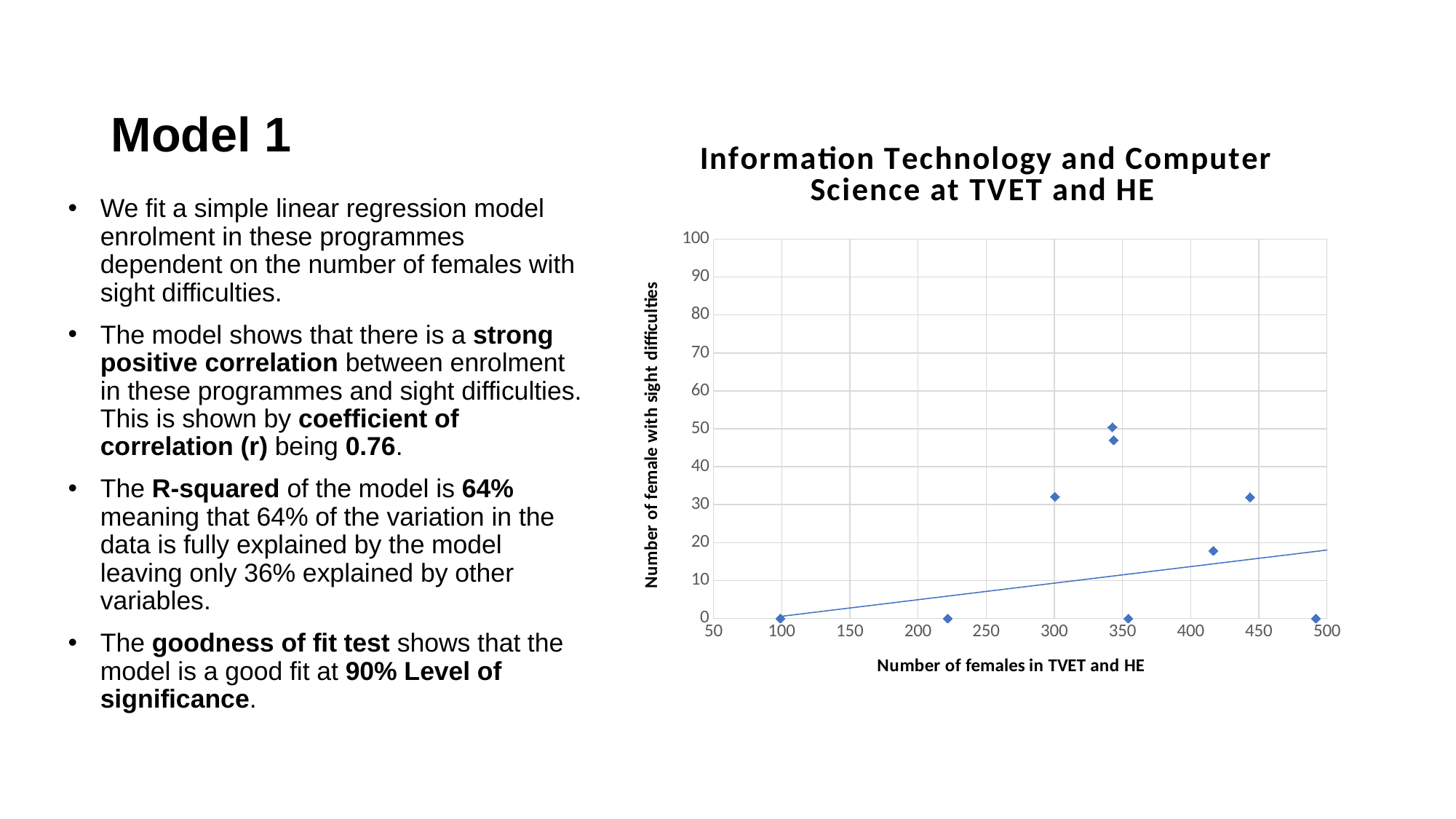
What is the maximum value shown on the y axis of the chart? 100 Is the highest plotted point on the chart greater or less than 40 on the y axis? greater What is the label of the x axis of the chart? Number of females in TVET and HE Is the value of the point plotted at about 420 on the x axis greater or less than 30 on the y axis? less What is the title of the chart? Information Technology and Computer Science at TVET and HE Is the value of the point plotted at about 300 on the x axis greater or less than 20 on the y axis? greater How many data points are plotted on the chart? 9 How many data points on the chart have a value of 0 on the y axis? 4 What kind of chart is shown on the slide? scatter chart Does the fitted trend line on the chart rise or fall as the number of females in TVET and HE increases? rises